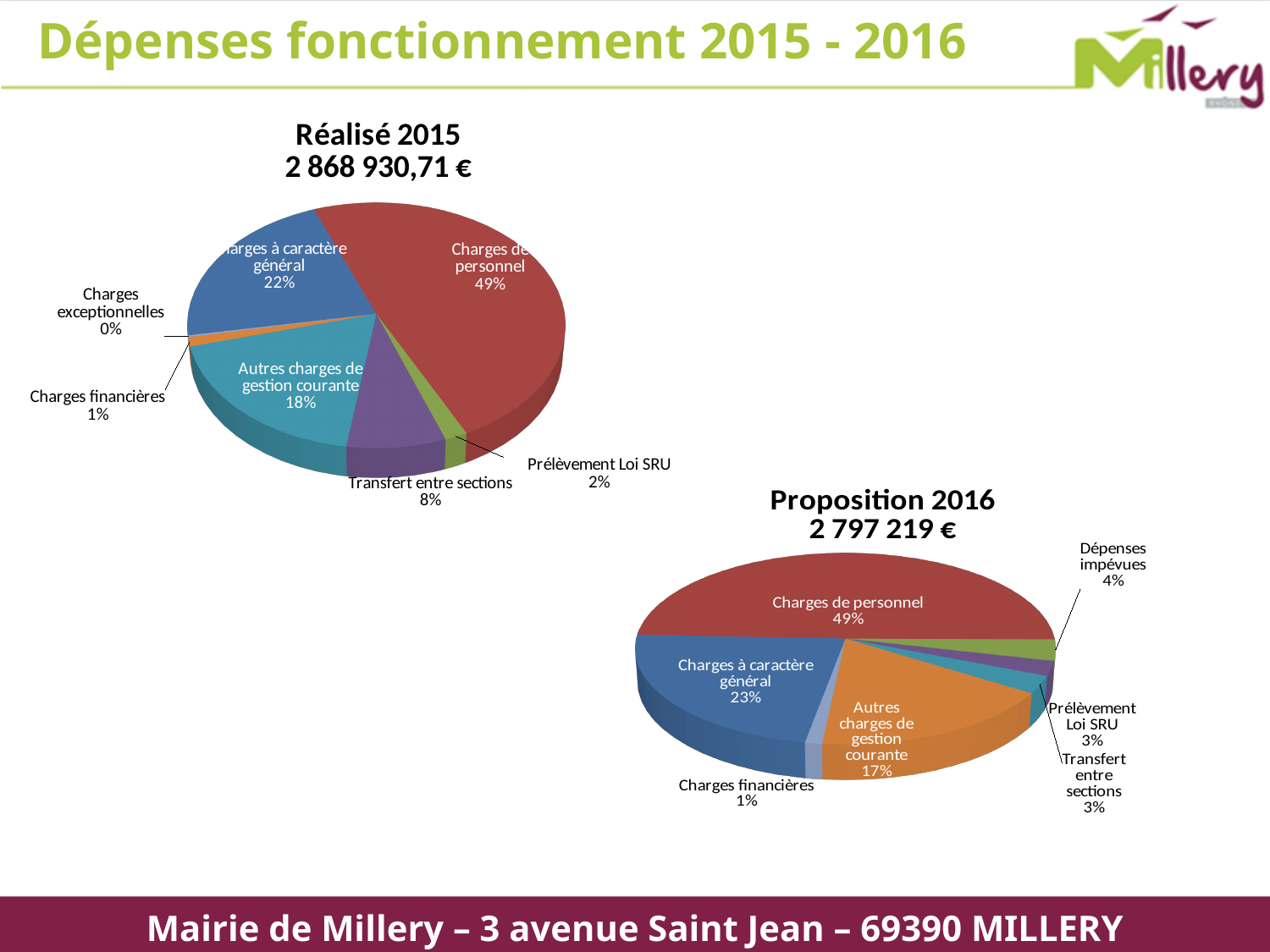
In the Proposition 2016 chart, what share is Dépenses impévues? 4% In the Proposition 2016 chart, which is larger, Autres charges de gestion courante or Prélèvement Loi SRU? Autres charges de gestion courante In the Proposition 2016 chart, which category has the smallest share? Charges financières In the Réalisé 2015 chart, what share is Charges de personnel? 49% In the Proposition 2016 chart, what share is Charges à caractère général? 23% In the Réalisé 2015 chart, what is the difference between Charges à caractère général and Transfert entre sections? 14 percentage points In the Réalisé 2015 chart, how many categories are shown? 7 What type of chart is the Proposition 2016 chart? Pie chart In the Réalisé 2015 chart, which category has the smallest share? Charges exceptionnelles What total amount is shown in the title of the Proposition 2016 chart? 2 797 219 € In the Réalisé 2015 chart, which category has the largest share? Charges de personnel